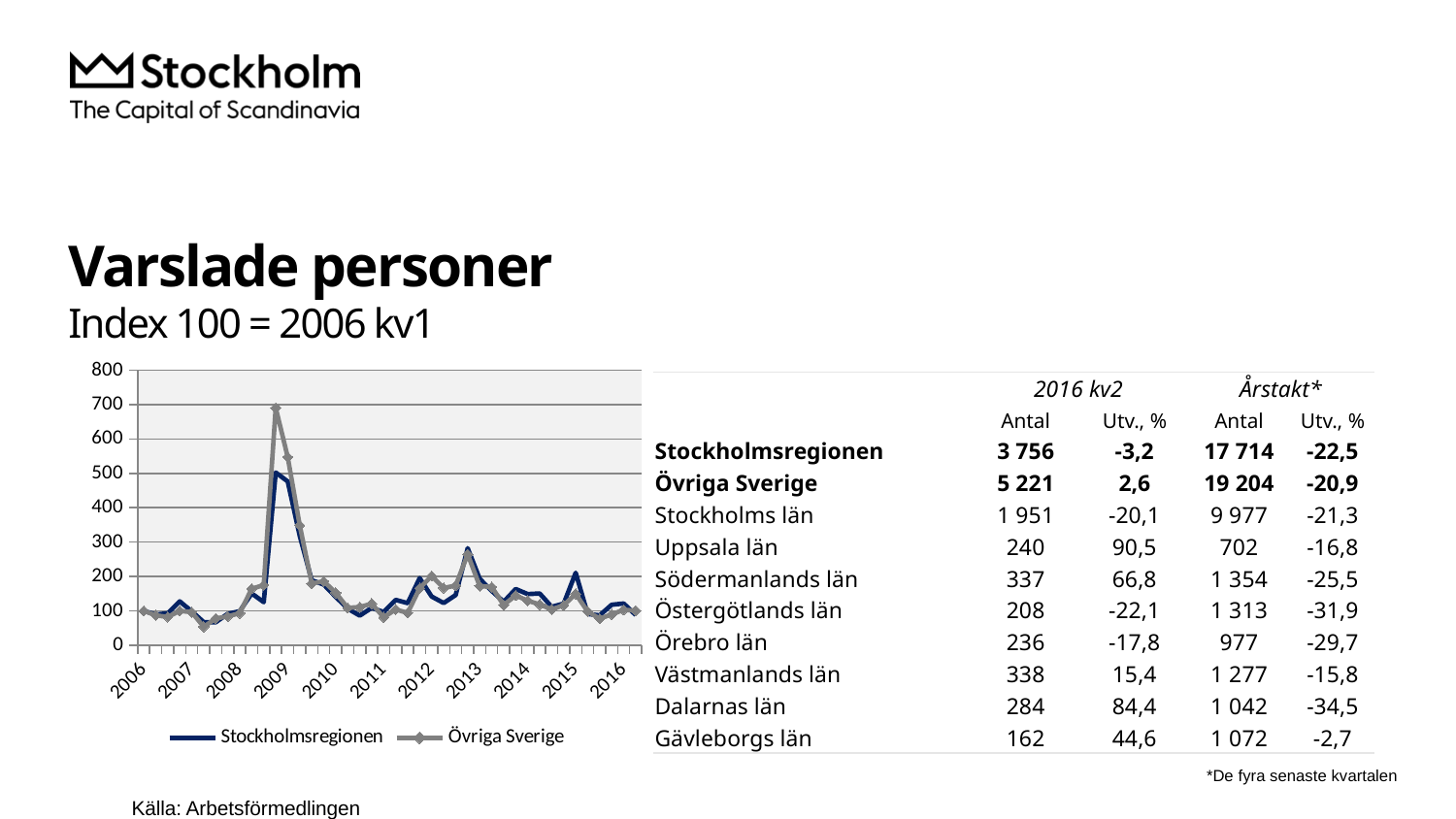
How many year labels are shown on the chart's x axis? 11 What kind of chart is shown on the slide? line chart What is the title of the chart? Varslade personer What is the highest value shown on the chart's y axis? 800 Is the peak value for Stockholmsregionen in 2009 greater or less than 400? greater How many series does the chart legend list? 2 Which series reaches the higher peak in 2009, Stockholmsregionen or Övriga Sverige? Övriga Sverige In which year do both series reach their highest values? 2009 Which two series are listed in the chart legend? Stockholmsregionen and Övriga Sverige Is the peak value for Övriga Sverige in 2009 greater or less than 600? greater Do the values for both series rise or fall from their 2009 peak to 2010? fall Is the peak value for Stockholmsregionen in 2009 greater or less than 600? less